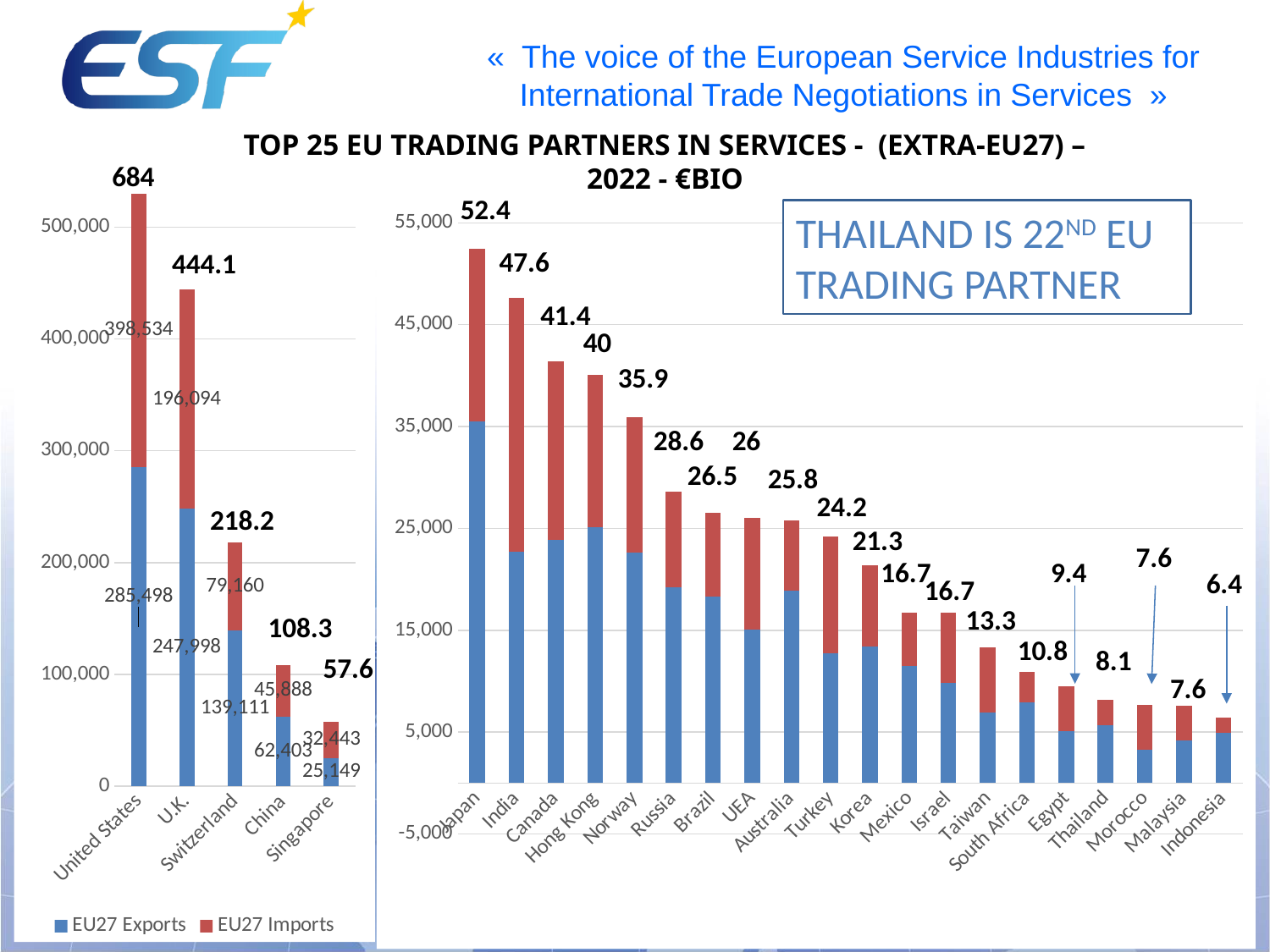
On the right chart, what is the difference between the totals labelled for Japan and India? 4.8 On the right chart, which has the larger total, Canada or Hong Kong? Canada On the right chart, how many countries are shown on the x axis? 20 What kind of chart is the right chart? Stacked bar chart On the left chart, how many series does the legend list? 2 On the left chart, which country has the lowest total? Singapore On the right chart, what is the total value labelled for Norway? 35.9 On the right chart, what is the total value labelled for Thailand? 8.1 On the left chart, what is the EU27 Imports value labelled for China? 45,888 On the left chart, what is the total value labelled for United States? 684 On the left chart, what is the EU27 Exports value labelled for Switzerland? 139,111 On the right chart, which country has the highest total? Japan